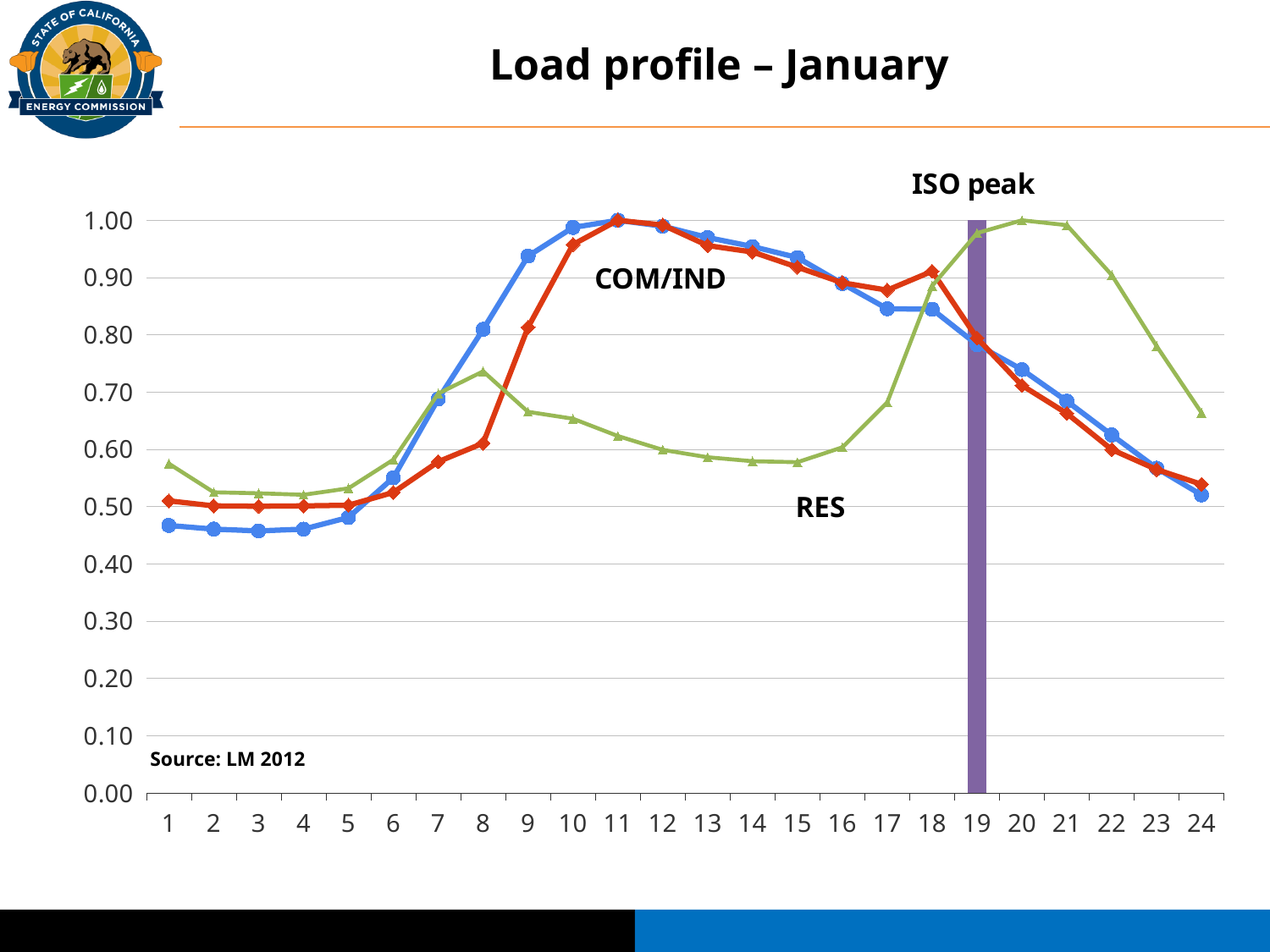
At which hour does the RES line reach its highest value? 20 Is the value of the red line at hour 9 greater or less than 0.90? less At hour 8, which is larger: the blue line or the red line? blue line What kind of chart is shown on the slide? line chart How many hours are shown along the x axis of the chart? 24 Is the value of the RES line at hour 1 greater or less than 0.50? greater Does the blue line rise or fall from hour 5 to hour 11? rise Is the value of the RES line at hour 20 greater or less than 0.90? greater Does the RES line rise or fall from hour 20 to hour 24? fall At which hour is the 'ISO peak' marker placed on the chart? 19 At hour 20, which is larger: the RES line or the blue line? RES